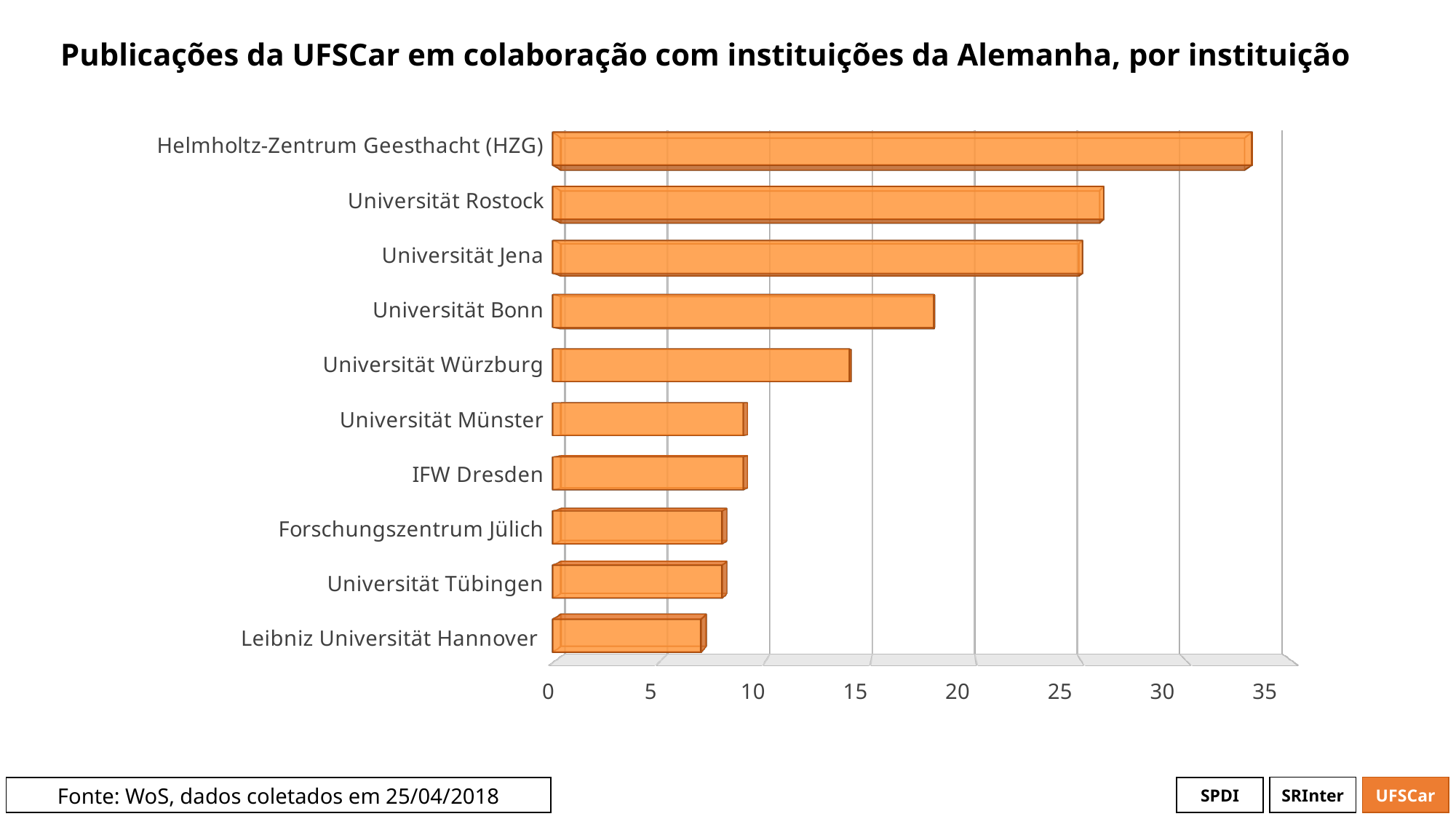
Is the value for Universität Münster greater or less than 10? less Is the value for Universität Bonn greater or less than 20? less Which institution has the lowest number of publications in the chart? Leibniz Universität Hannover Are the bars ordered from largest to smallest going from top to bottom? Yes Is the value for Helmholtz-Zentrum Geesthacht (HZG) greater or less than 30? greater How many institutions are shown in the chart? 10 What is the title of the chart? Publicações da UFSCar em colaboração com instituições da Alemanha, por instituição Which has more publications, Universität Bonn or Universität Würzburg? Universität Bonn Which institution has the highest number of publications in collaboration with UFSCar? Helmholtz-Zentrum Geesthacht (HZG) What kind of chart is shown on the slide? bar chart